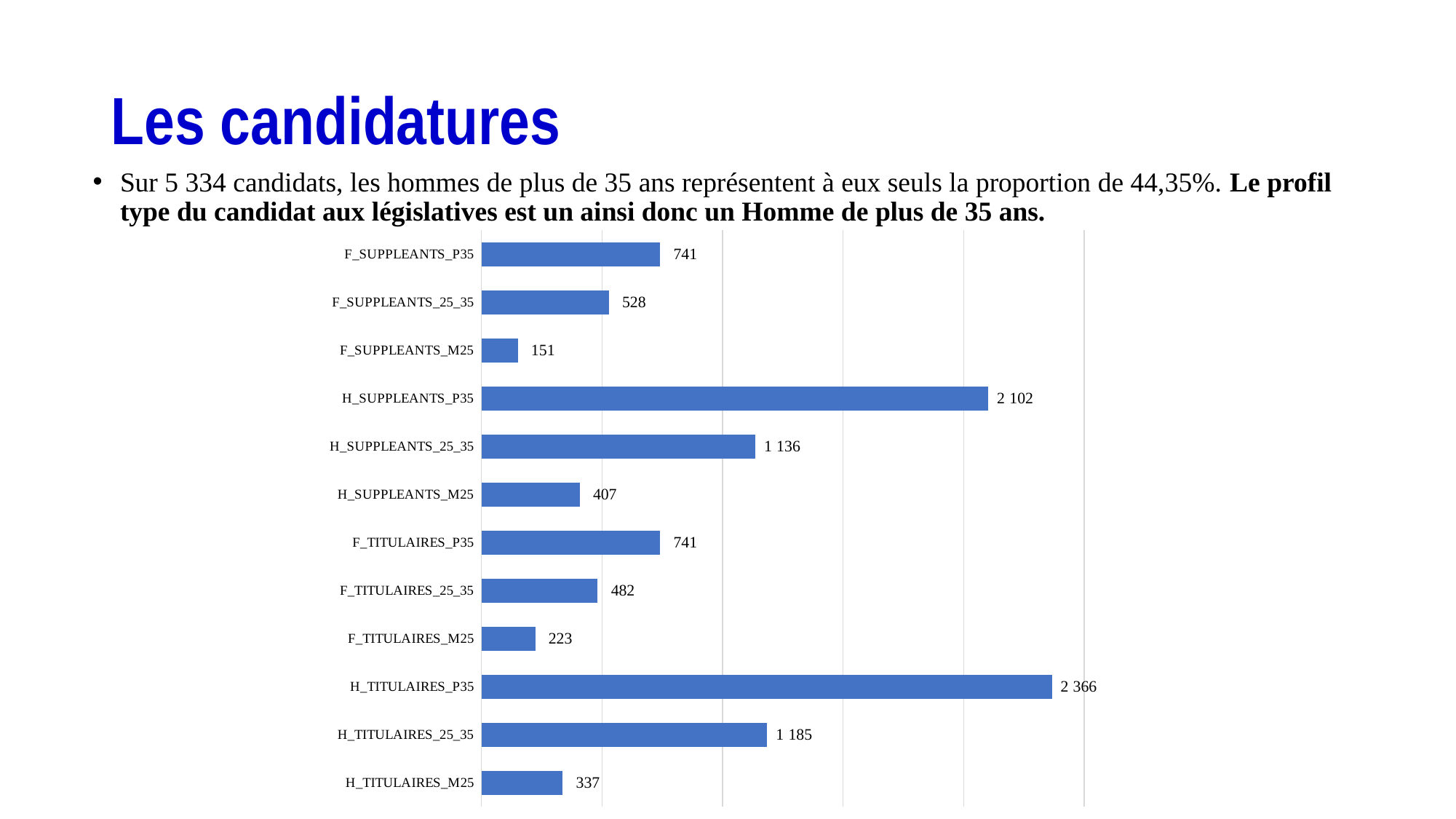
What is the value for H_TITULAIRES_P35? 2 366 What is the difference between the values for H_TITULAIRES_P35 and H_SUPPLEANTS_P35? 264 Which is larger, the value for H_SUPPLEANTS_M25 or the value for H_TITULAIRES_M25? H_SUPPLEANTS_M25 What is the value for F_SUPPLEANTS_25_35? 528 What is the value for H_SUPPLEANTS_M25? 407 What is the difference between the values for F_SUPPLEANTS_P35 and F_SUPPLEANTS_25_35? 213 Which is larger, the value for H_SUPPLEANTS_25_35 or the value for F_SUPPLEANTS_25_35? H_SUPPLEANTS_25_35 Which category has the lowest value? F_SUPPLEANTS_M25 Which category has the highest value? H_TITULAIRES_P35 What is the value for F_TITULAIRES_M25? 223 How many categories are shown in the chart? 12 What kind of chart is shown on the slide? Bar chart